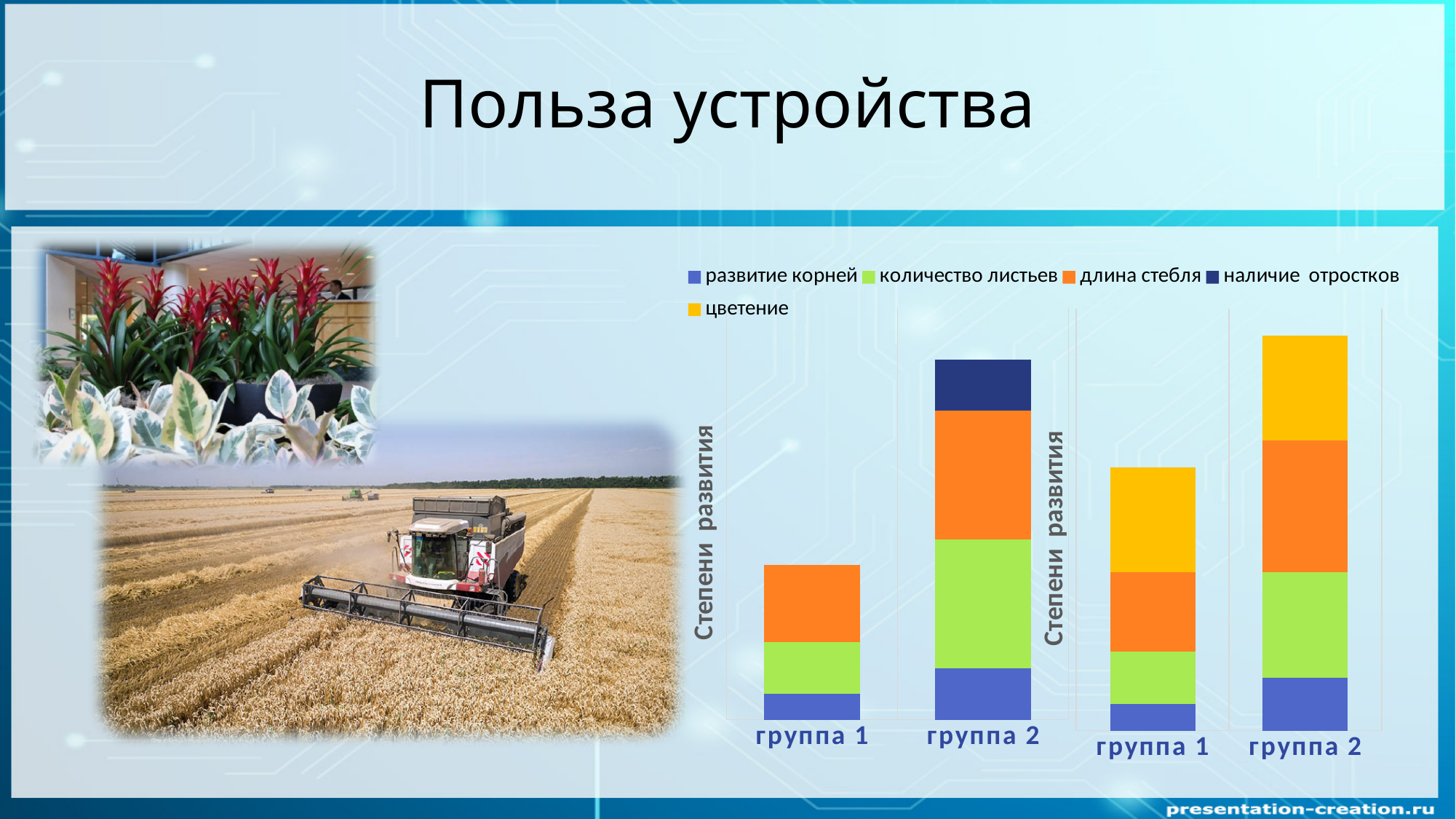
How many series does the legend at the top of the slide list? 5 What is the title of the vertical axis on both charts? Степени развития In the left chart, how many coloured segments make up the bar for группа 1? 3 What kind of chart is shown on the left of the two charts? stacked bar chart In the left chart, how many coloured segments make up the bar for группа 2? 4 In the left chart, for группа 2, which segment is larger: длина стебля or развитие корней? длина стебля In the left chart, how many groups are shown on the x axis? 2 In the left chart, which group has the taller stacked bar? группа 2 In the right chart, which series forms the top segment of each bar? цветение In the right chart, for группа 1, which segment is larger: цветение or развитие корней? цветение In the right chart, which group has the shorter stacked bar? группа 1